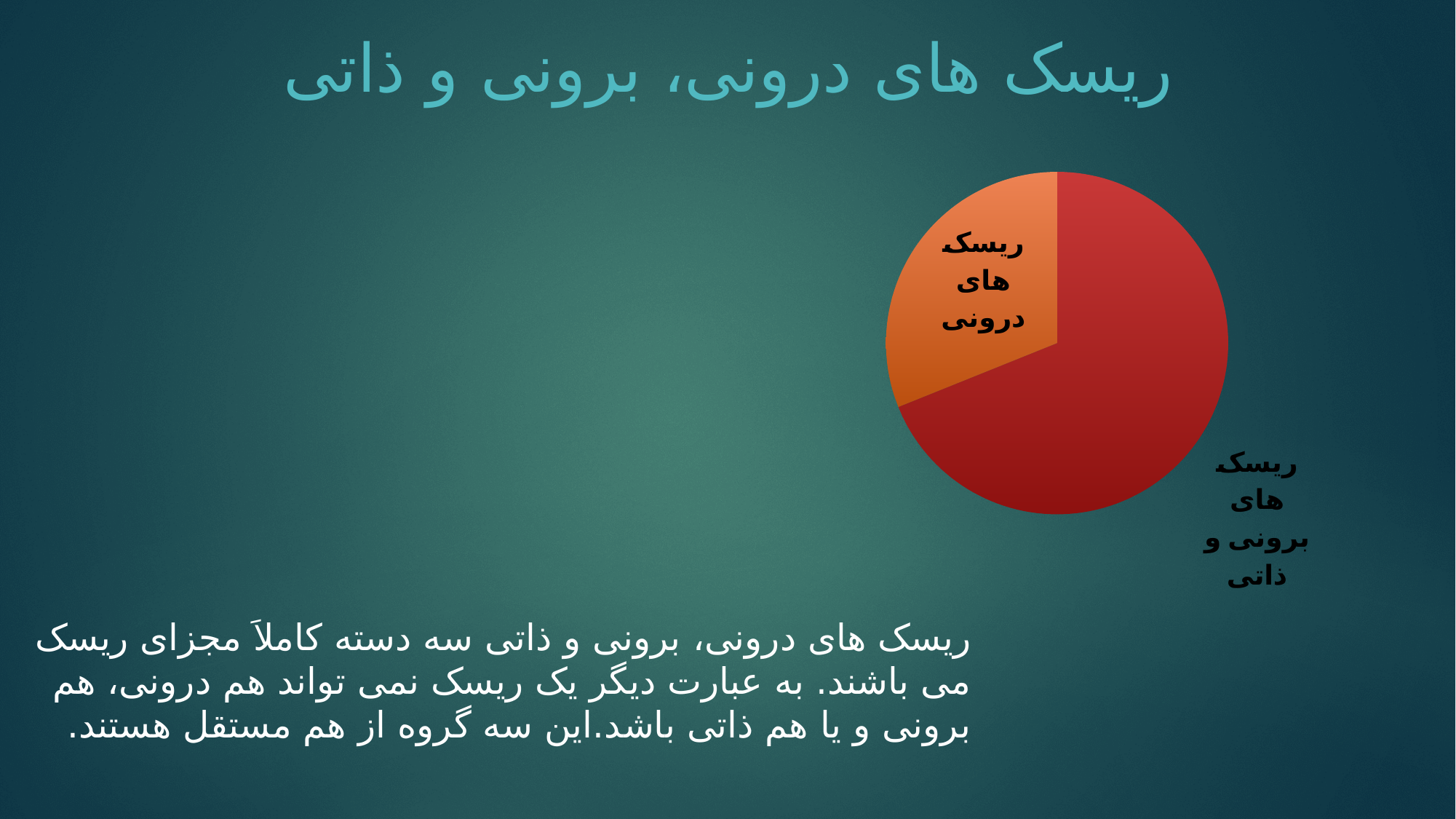
Which slice is larger: ریسک های درونی or ریسک های برونی و ذاتی? ریسک های برونی و ذاتی How many slices does the pie chart have? 2 Does the slice for ریسک های درونی take up more or less than half of the pie? less Does the slice for ریسک های برونی و ذاتی take up more or less than half of the pie? more What colour is the slice labelled ریسک های درونی? Orange What colour is the slice labelled ریسک های برونی و ذاتی? Red Which slice of the pie chart is the smallest? ریسک های درونی Which slice of the pie chart is the largest? ریسک های برونی و ذاتی What kind of chart is shown on the slide? Pie chart